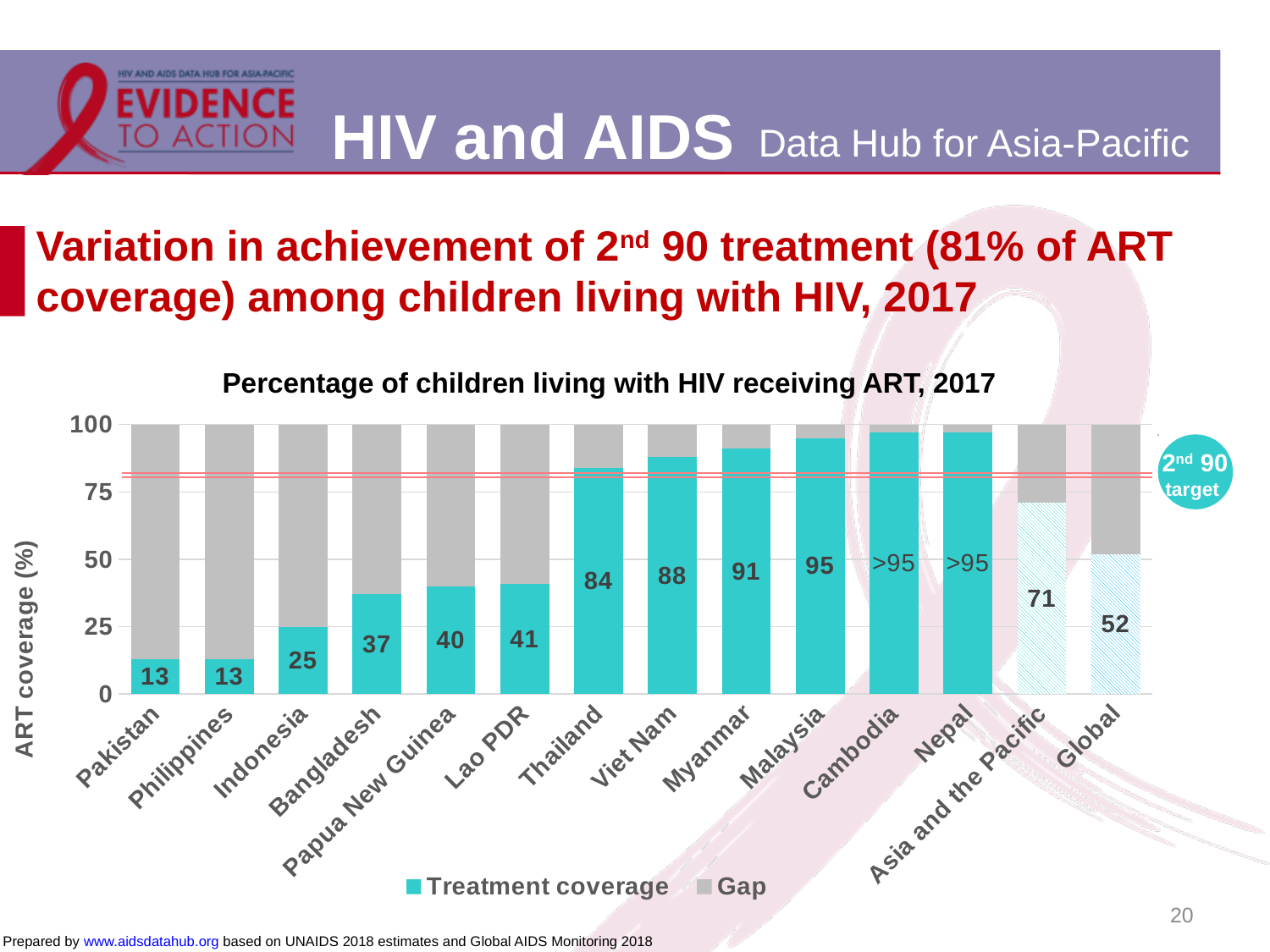
Is the treatment coverage value for Bangladesh greater or less than 25? greater What is the total of the stacked bar for Pakistan (treatment coverage plus gap)? 100 Which has higher treatment coverage, Myanmar or Viet Nam? Myanmar What is the treatment coverage value for Thailand? 84 What is the difference in treatment coverage between Thailand and Lao PDR? 43 What is the difference in treatment coverage between Asia and the Pacific and Global? 19 How many series does the legend list? 2 What is the treatment coverage value shown for Cambodia? >95 How many countries or regions are shown on the x axis? 14 What is the treatment coverage value for Global? 52 What is the treatment coverage value for Asia and the Pacific? 71 What kind of chart is shown on the slide? Stacked bar chart